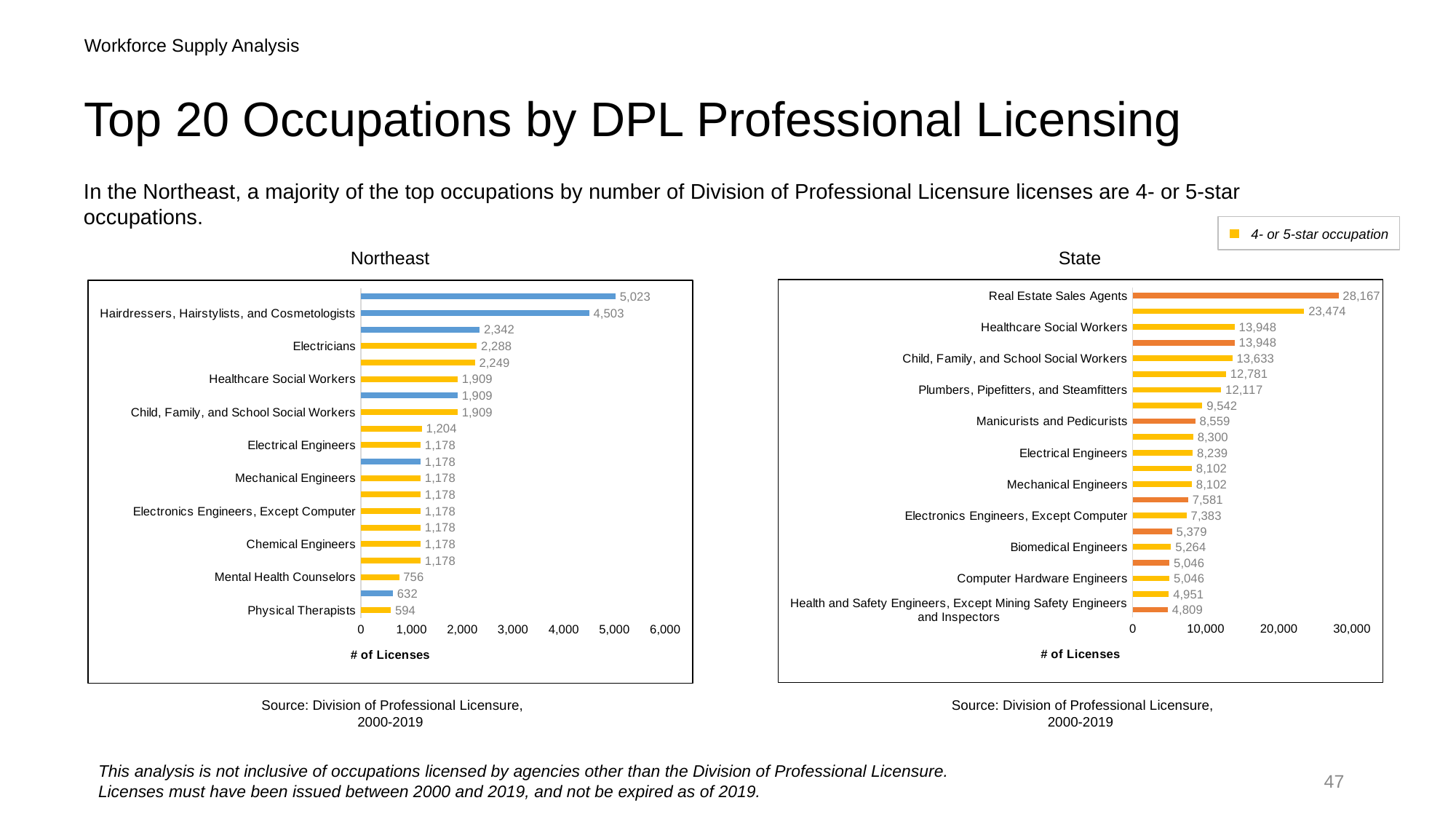
In the State chart, how many licenses are shown for Real Estate Sales Agents? 28,167 What does the yellow colour in the legend indicate? 4- or 5-star occupation What kind of chart is the State chart? Bar chart In the State chart, which has more licenses: Manicurists and Pedicurists or Biomedical Engineers? Manicurists and Pedicurists In the State chart, how many licenses are shown for Plumbers, Pipefitters, and Steamfitters? 12,117 In the State chart, which labeled occupation has the highest number of licenses? Real Estate Sales Agents In the Northeast chart, what is the difference in licenses between Hairdressers, Hairstylists, and Cosmetologists and Electricians? 2,215 In the State chart, what is the difference in licenses between Real Estate Sales Agents and Healthcare Social Workers? 14,219 In the Northeast chart, how many licenses are shown for Hairdressers, Hairstylists, and Cosmetologists? 4,503 In the Northeast chart, which labeled occupation has the lowest number of licenses? Physical Therapists How many bars are plotted in the Northeast chart? 20 In the Northeast chart, how many licenses are shown for Mental Health Counselors? 756